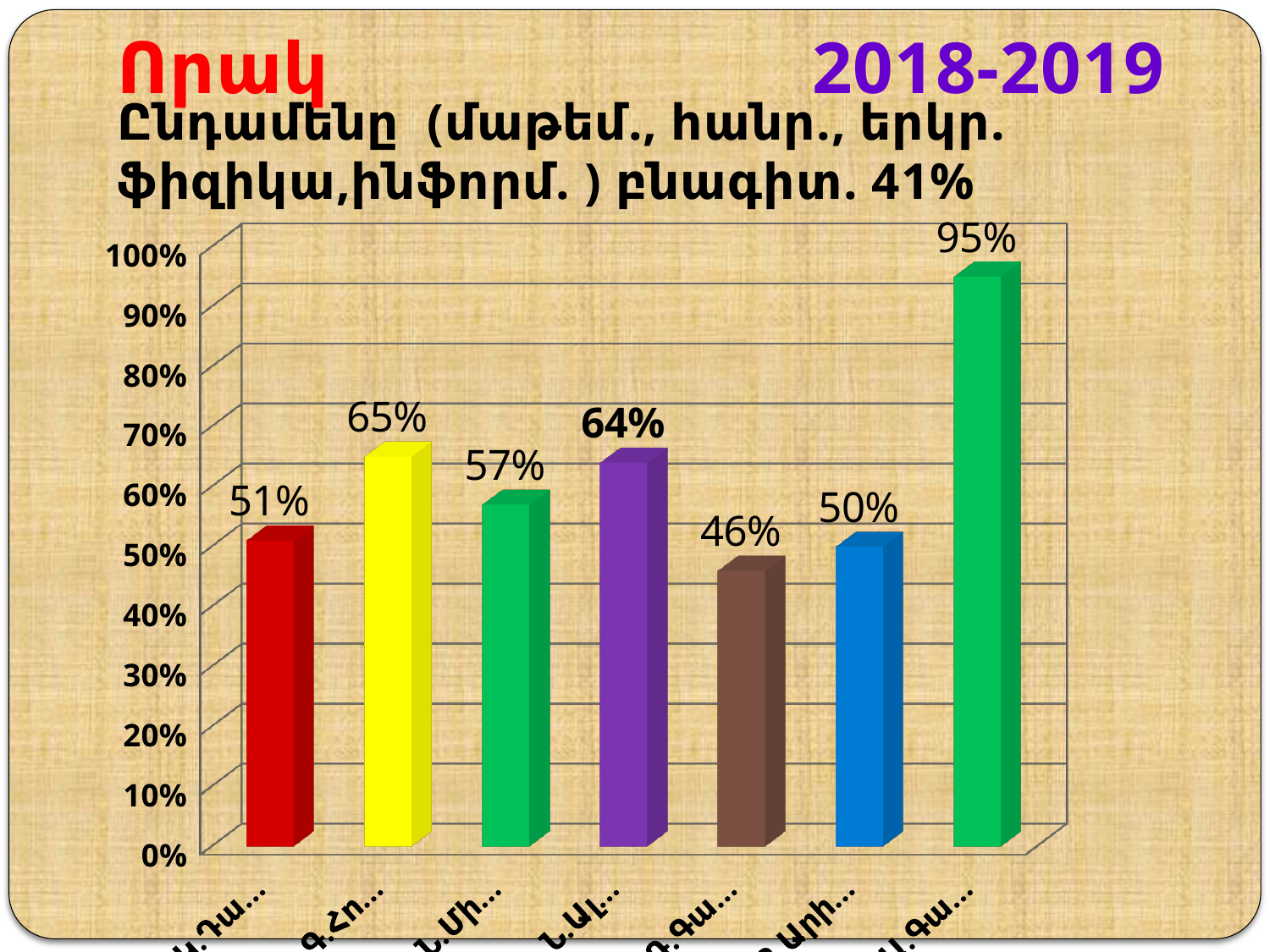
Which is larger, the value of the yellow bar or the value of the purple bar? the yellow bar (65%) How many bars are plotted in the chart? 7 What is the highest value shown in the chart? 95% What is the value of the first (red) bar in the chart? 51% What is the highest value shown on the vertical axis of the chart? 100% What is the value of the fifth (brown) bar in the chart? 46% What is the lowest value shown in the chart? 46% What is the value of the sixth (blue) bar in the chart? 50% What is the difference between the last (rightmost) bar and the first (red) bar? 44% What is the value of the fourth (purple) bar in the chart? 64% What type of chart is shown on the slide? bar chart What is the value of the second (yellow) bar in the chart? 65%